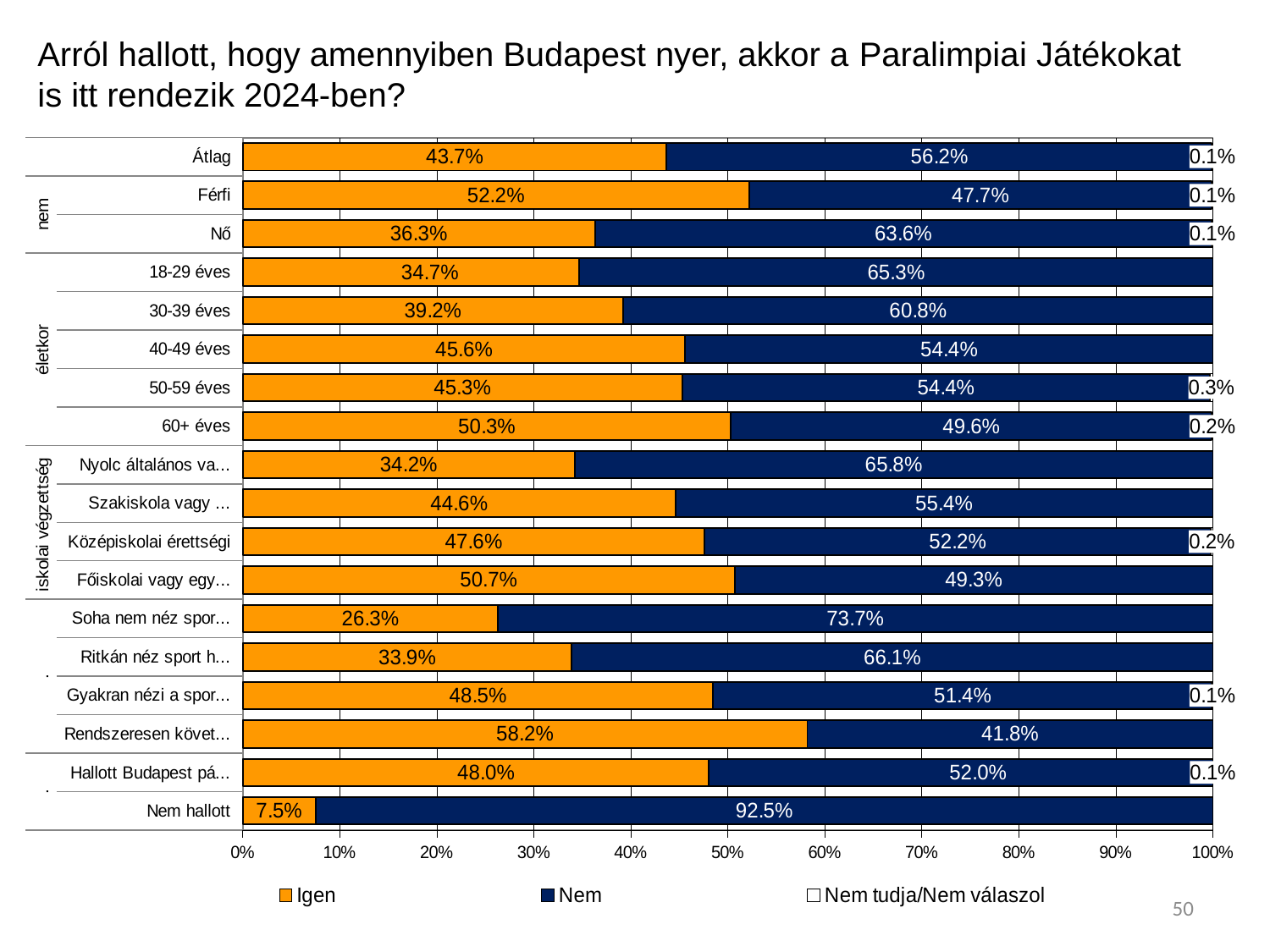
Is the 'Igen' value for 'Soha nem néz spor...' greater or less than 30%? less What is the 'Nem tudja/Nem válaszol' value for 50-59 éves? 0.3% Which category has the lowest 'Igen' value? Nem hallott What is the 'Igen' value for Átlag? 43.7% Which category has the highest 'Igen' value? Rendszeresen követ... What is the difference between the 'Igen' values for Férfi and Nő? 15.9 percentage points What are the three legend entries of the chart? Igen, Nem, Nem tudja/Nem válaszol Which category has the highest 'Nem' value? Nem hallott What type of chart is shown on the slide? Stacked bar chart How many series does the legend list? 3 Which has the larger 'Igen' value, 18-29 éves or 60+ éves? 60+ éves What is the 'Nem' value for Nő? 63.6%